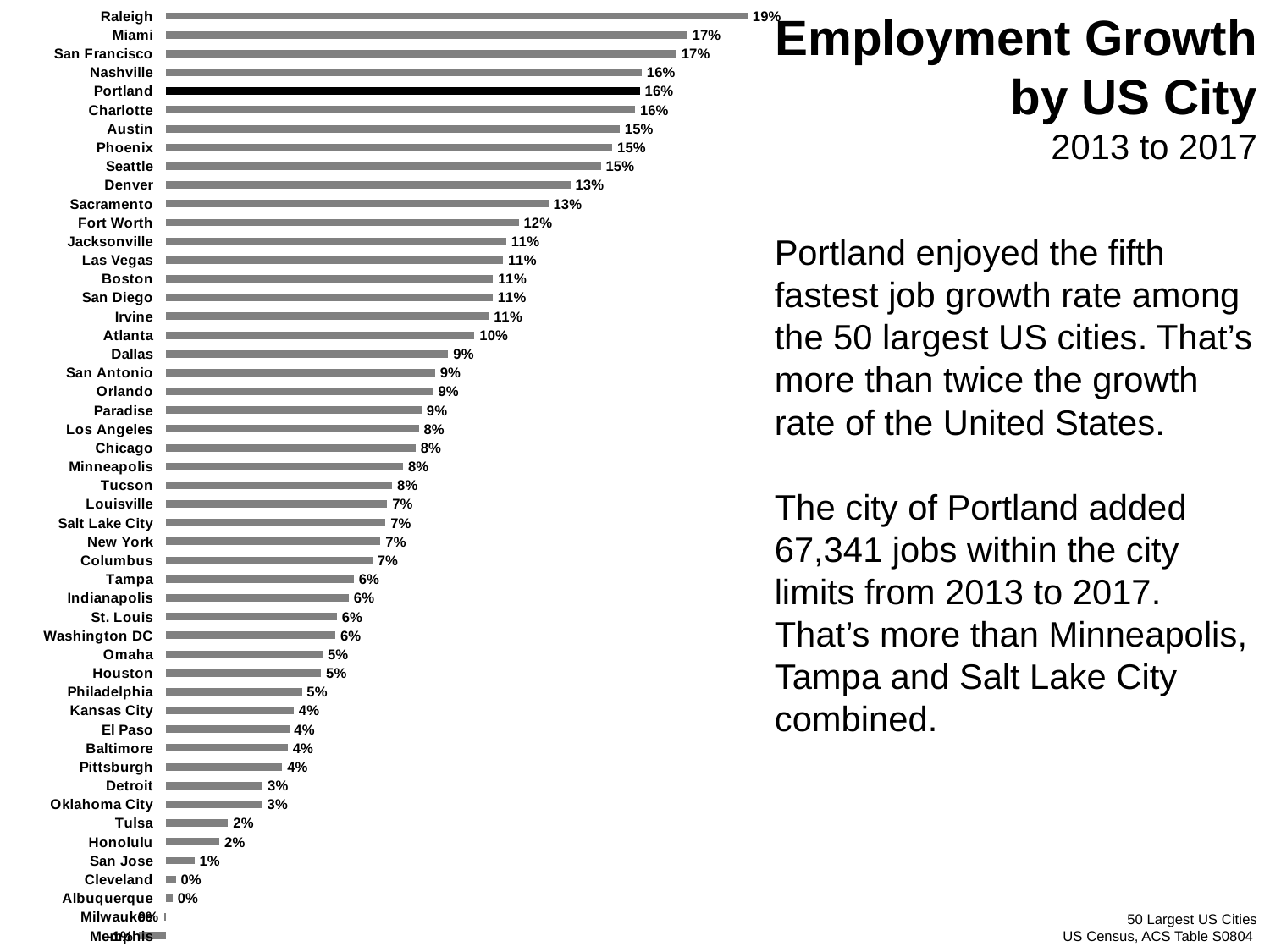
Which city has the highest employment growth in the chart? Raleigh Which city has the lowest employment growth in the chart? Memphis What is the employment growth value shown for Portland? 16% Which city has a larger employment growth value, Houston or Tulsa? Houston What is the title of the chart on the slide? Employment Growth by US City What is the employment growth value shown for San Jose? 1% How many cities are shown in the chart? 50 What kind of chart is shown on the slide? Bar chart What is the difference between the employment growth values for Raleigh and Portland? 3% What is the employment growth value shown for Raleigh? 19% What is the employment growth value shown for Minneapolis? 8% Which city has a larger employment growth value, Denver or Atlanta? Denver